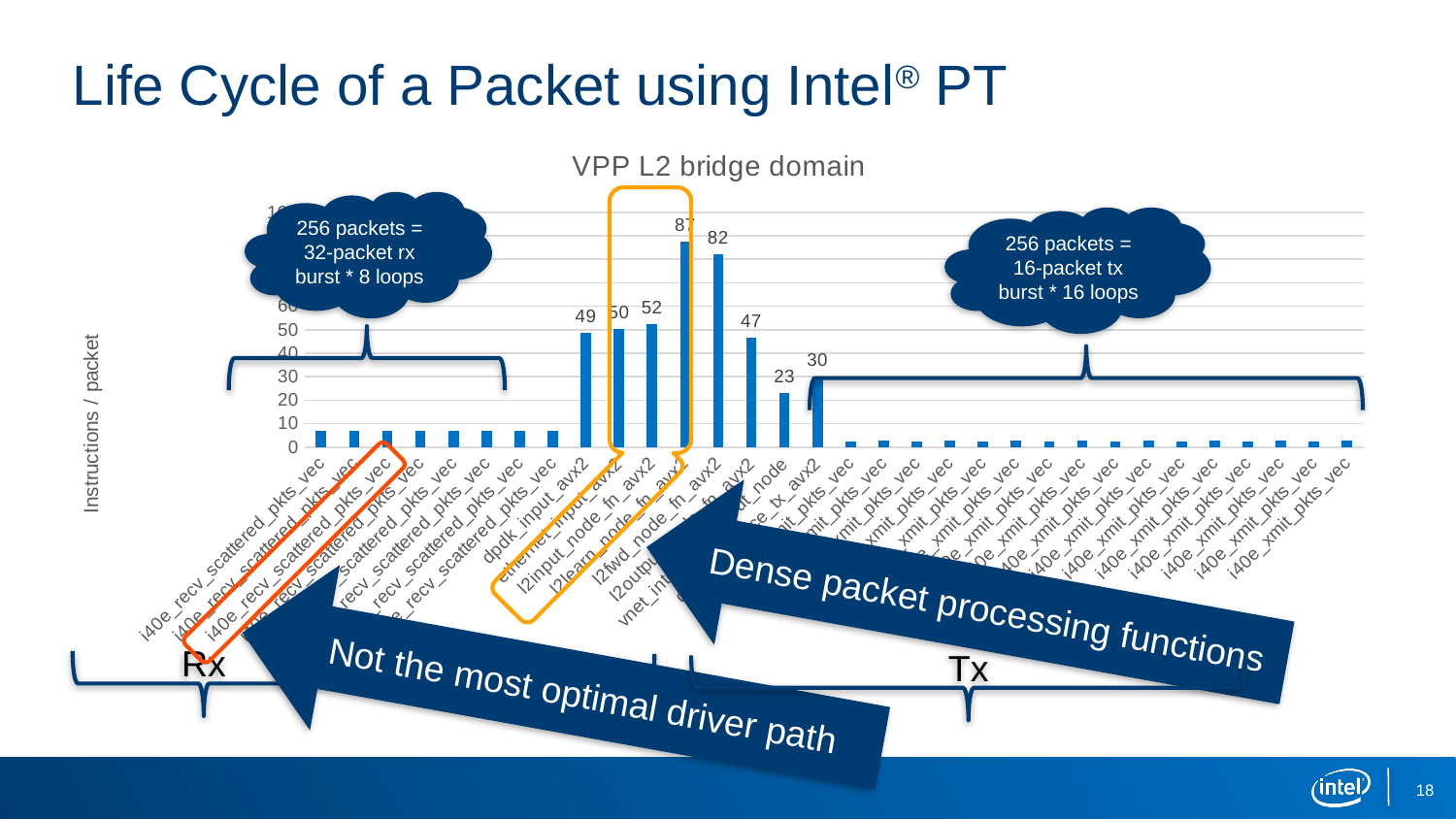
Is the value for l2input_node_fn_avx2 greater or less than 40? greater What is the highest value labelled on the chart? 87 What is the title of the chart? VPP L2 bridge domain What is the label of the vertical axis of the chart? Instructions / packet What is the value for l2learn_node_fn_avx2? 87 What is the difference between the bars labelled 30 and 23? 7 What is the difference between the two tallest bars, labelled 87 and 82? 5 Are the i40e_xmit_pkts_vec bars on the right side of the chart greater or less than 10? less What kind of chart is shown on the slide? bar chart Is the value for the first i40e_recv_scattered_pkts_vec bar greater or less than 10? less Which is larger, the bar labelled 82 or the bar labelled 47? 82 What is the value for dpdk_input_avx2? 49